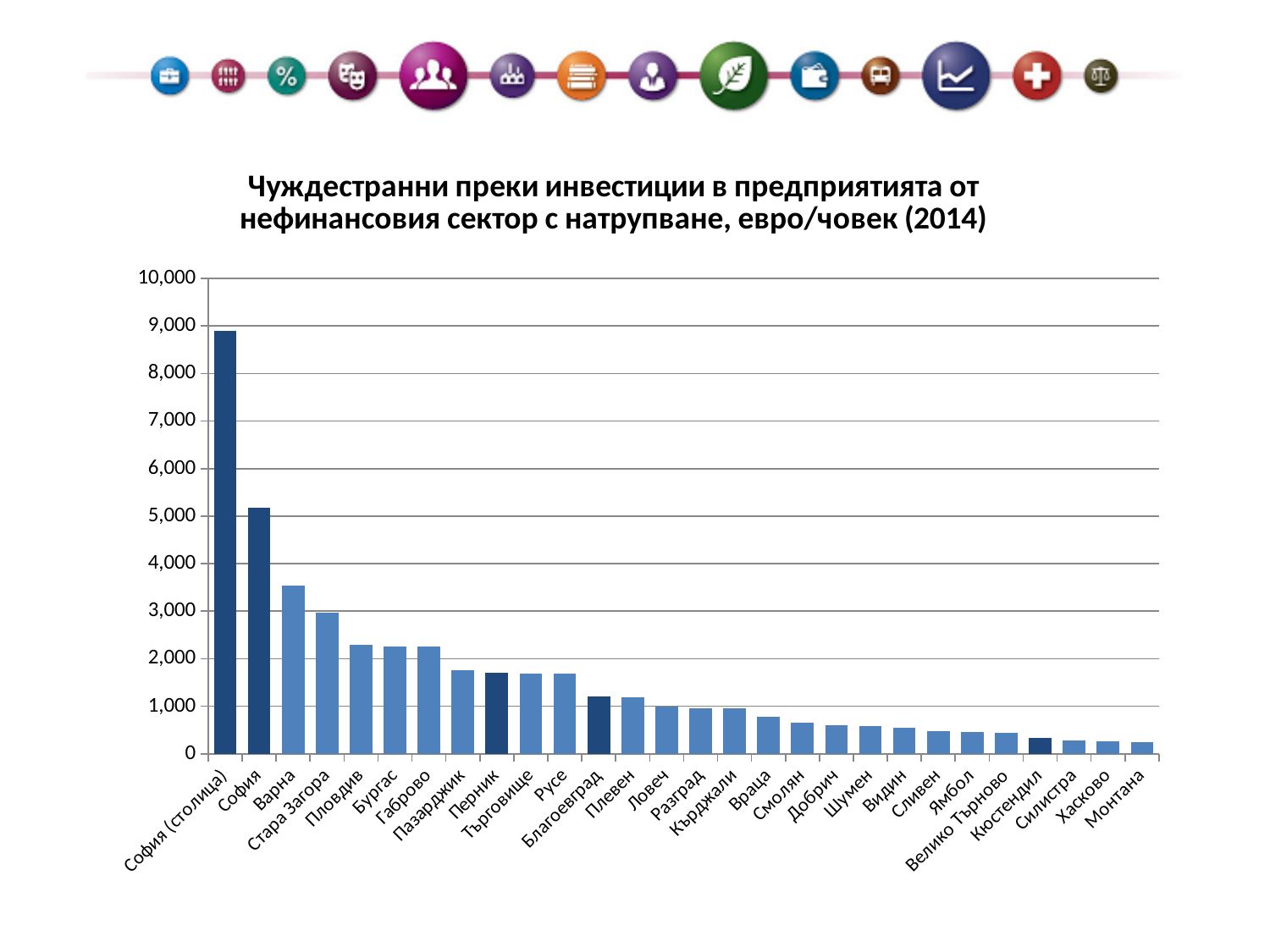
What kind of chart is shown on the slide? bar chart Is the value for София (столица) greater or less than 8,000? greater Which has the larger value, Варна or Стара Загора? Варна Which region has the highest value on the chart? София (столица) Is the value for Варна greater or less than 3,000? greater Is the value for София greater or less than 4,000? greater What year is given in the chart title? 2014 How many categories (regions) are plotted on the chart? 28 Do the values rise or fall moving from left to right along the x axis? fall